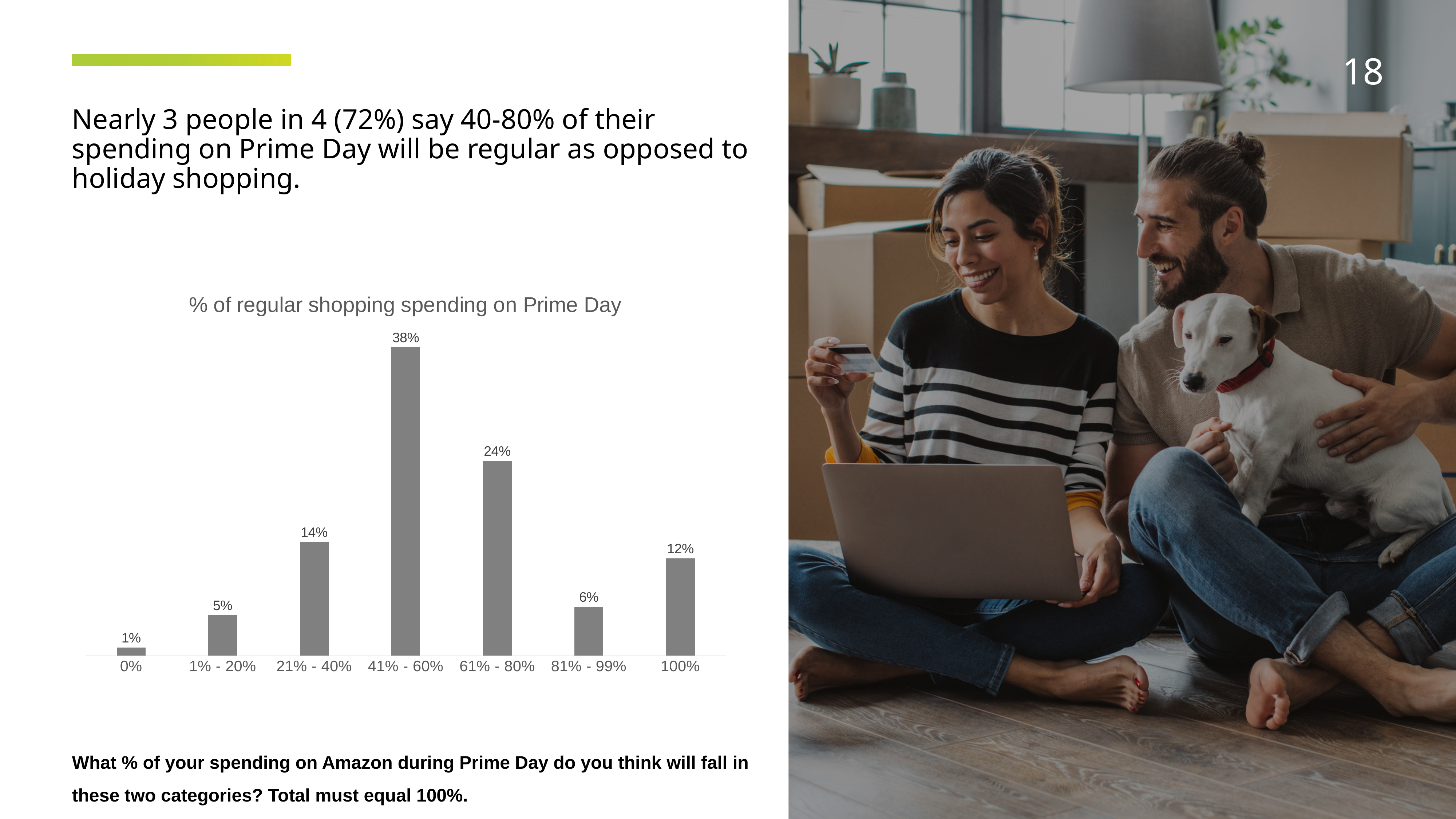
What is the difference between the values for 41% - 60% and 61% - 80%? 14% How many categories are shown on the x axis? 7 What kind of chart is shown on the slide? Bar chart What is the value for the 100% category? 12% What is the value for the 81% - 99% category? 6% Which category has the lowest value? 0% What is the value for the 41% - 60% category? 38% Which is larger, the value for 21% - 40% or the value for 100%? 21% - 40% What is the title of the chart? % of regular shopping spending on Prime Day What is the value for the 1% - 20% category? 5% What is the combined value of the 41% - 60% and 61% - 80% categories? 62% Which category has the highest value? 41% - 60%